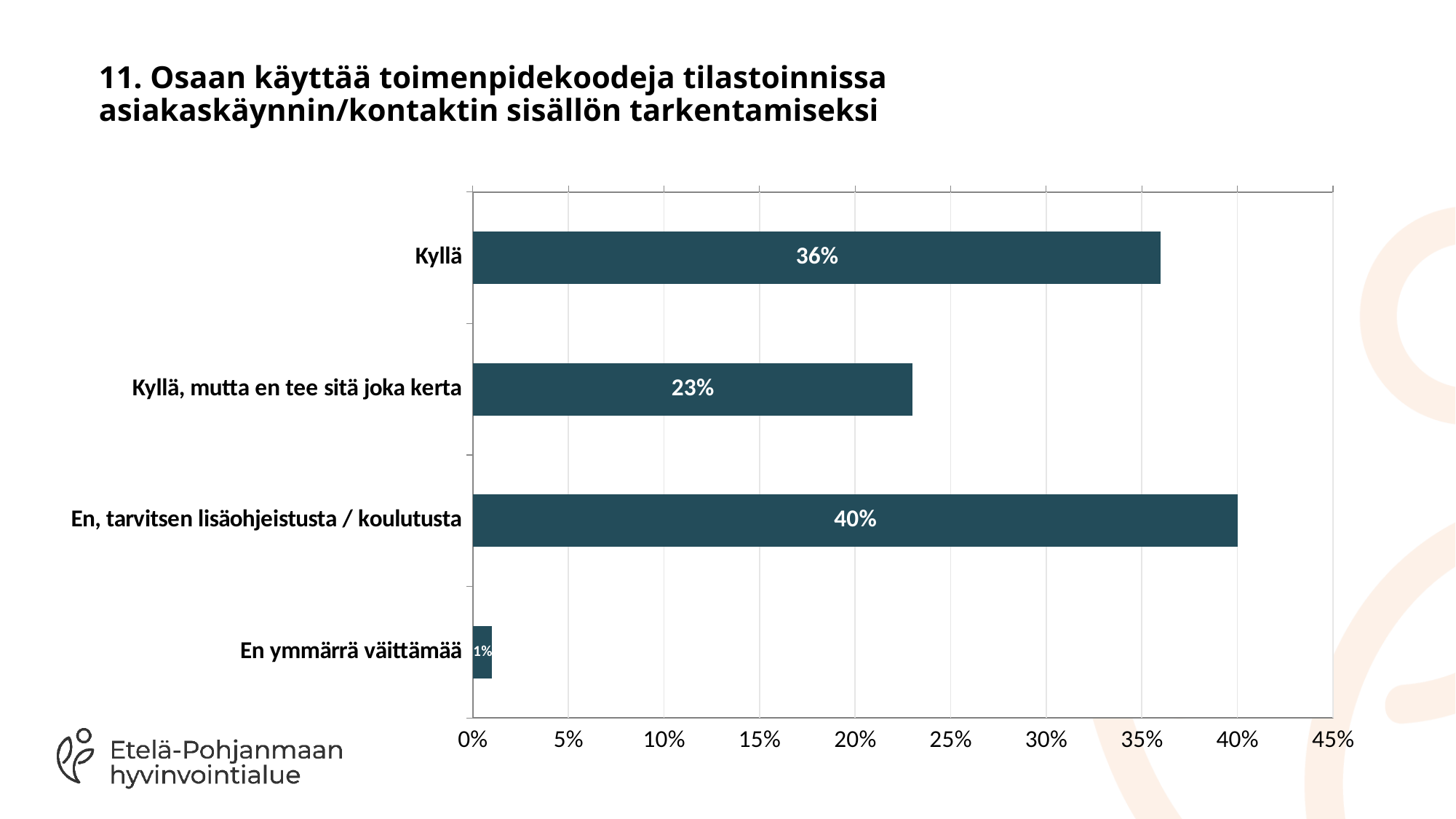
Is the value for "Kyllä, mutta en tee sitä joka kerta" greater or less than 25%? less Which category has the highest value? En, tarvitsen lisäohjeistusta / koulutusta What is the value for "Kyllä, mutta en tee sitä joka kerta"? 23% What is the value for "Kyllä"? 36% What kind of chart is shown on the slide? Bar chart How many categories are shown in the chart? 4 Which is larger, the value for "Kyllä" or the value for "Kyllä, mutta en tee sitä joka kerta"? Kyllä Which category has the lowest value? En ymmärrä väittämää What is the value for "En, tarvitsen lisäohjeistusta / koulutusta"? 40% What is the value for "En ymmärrä väittämää"? 1% What is the difference between the values for "En, tarvitsen lisäohjeistusta / koulutusta" and "Kyllä"? 4% What is the difference between the values for "Kyllä" and "Kyllä, mutta en tee sitä joka kerta"? 13%